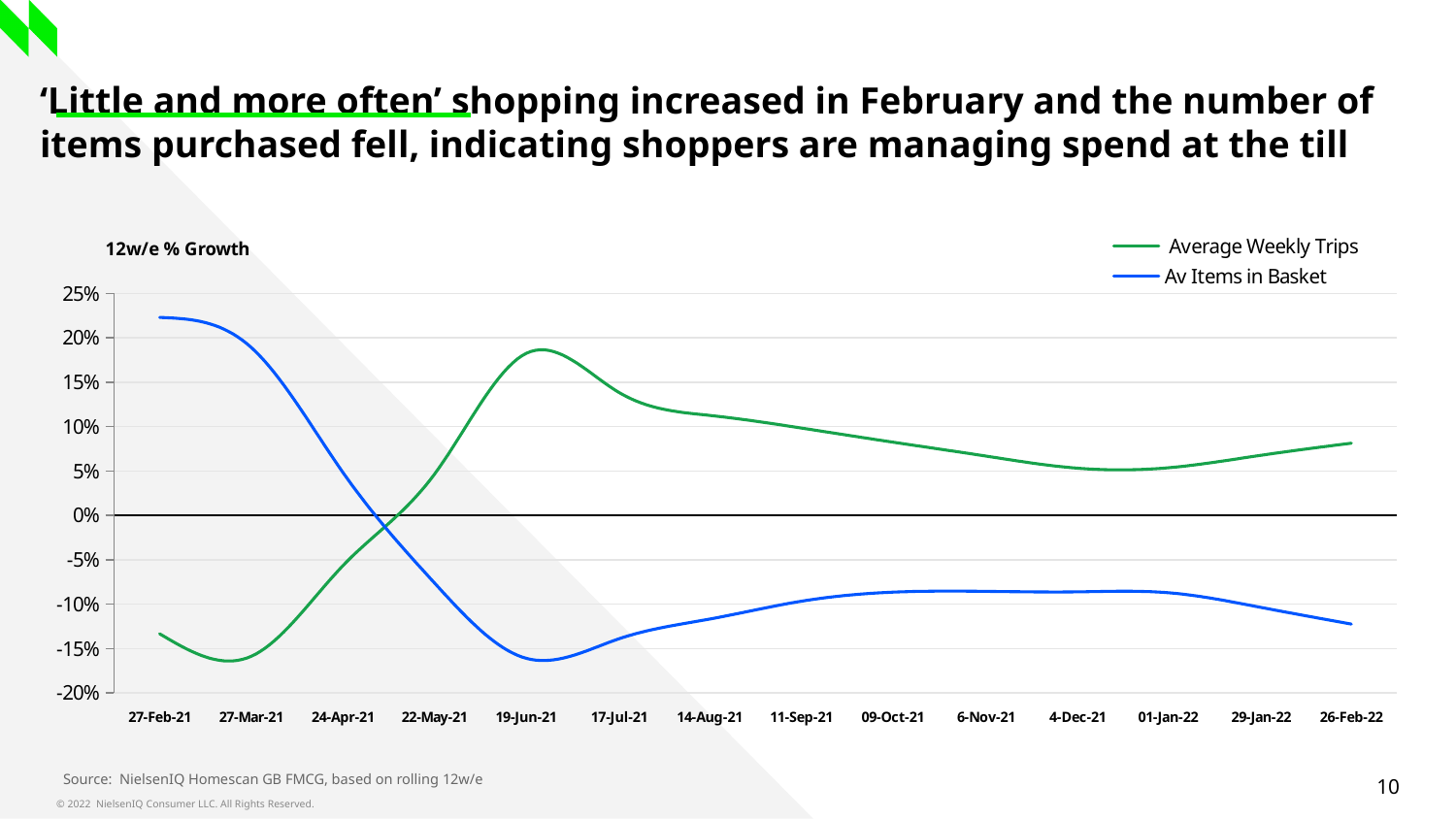
At 26-Feb-22, which series has the higher value, Average Weekly Trips or Av Items in Basket? Average Weekly Trips Is the value for Average Weekly Trips at 27-Mar-21 greater or less than -10%? less At which date does Av Items in Basket reach its lowest value? 19-Jun-21 How many series does the legend list? 2 At which date does Average Weekly Trips reach its highest value? 19-Jun-21 Is the value for Av Items in Basket at 27-Feb-21 greater or less than 20%? greater What is the title shown above the chart's y axis? 12w/e % Growth How many dates are shown along the x axis? 14 Is the value for Average Weekly Trips at 19-Jun-21 greater or less than 15%? greater What kind of chart is shown on the slide? Line chart Which series is drawn in blue? Av Items in Basket